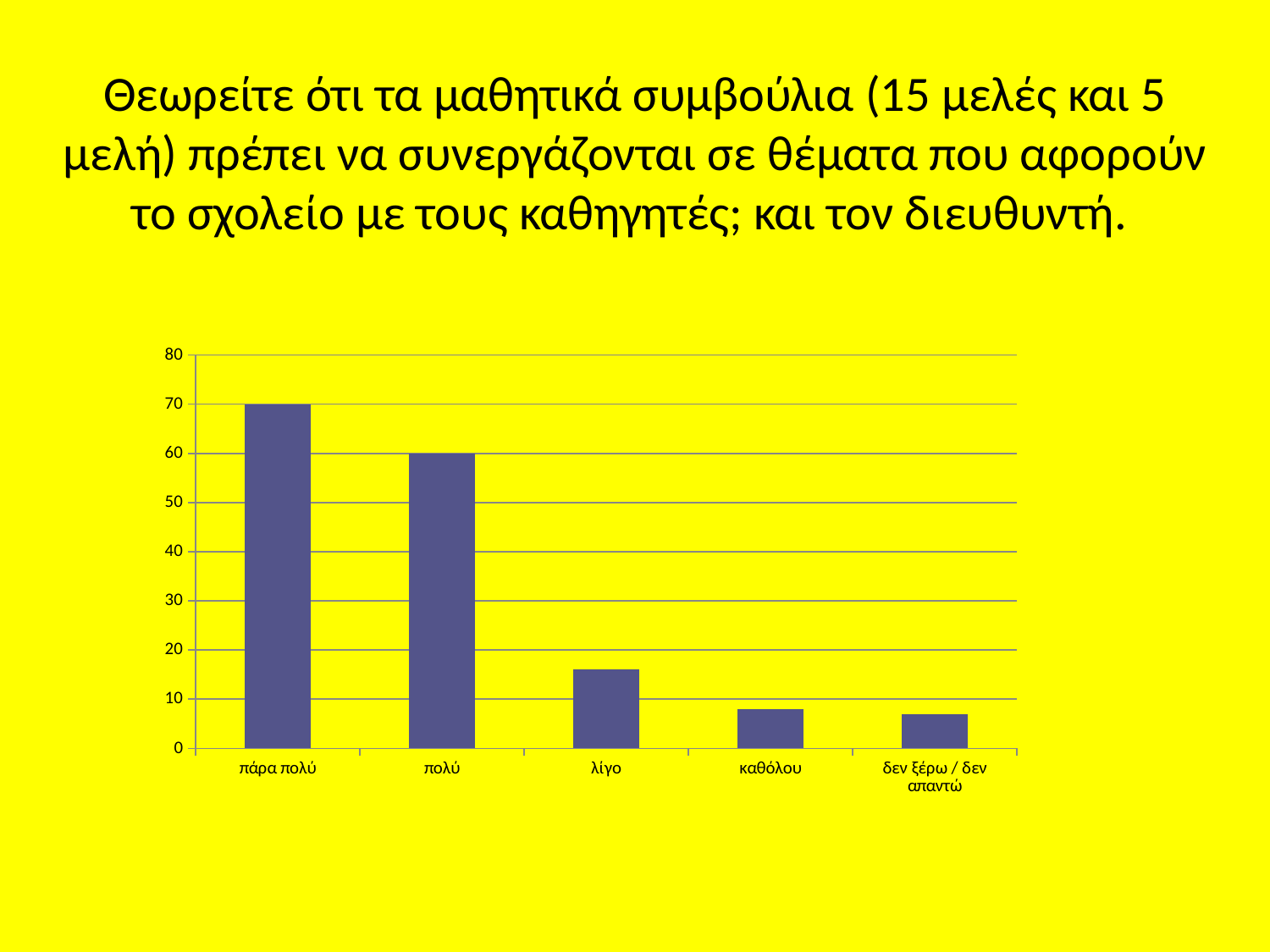
What is the difference between the values for πάρα πολύ and πολύ? 10 What is the value for πολύ? 60 How many categories are shown on the x axis? 5 Do the values rise or fall from left to right along the x axis? fall What is the value for πάρα πολύ? 70 Which is larger, the value for λίγο or the value for καθόλου? λίγο Which is larger, the value for πολύ or the value for λίγο? πολύ Is the value for λίγο greater or less than 20? less What kind of chart is shown on the slide? bar chart Is the value for καθόλου greater or less than 10? less Which category has the highest value? πάρα πολύ Is the value for λίγο greater or less than 10? greater